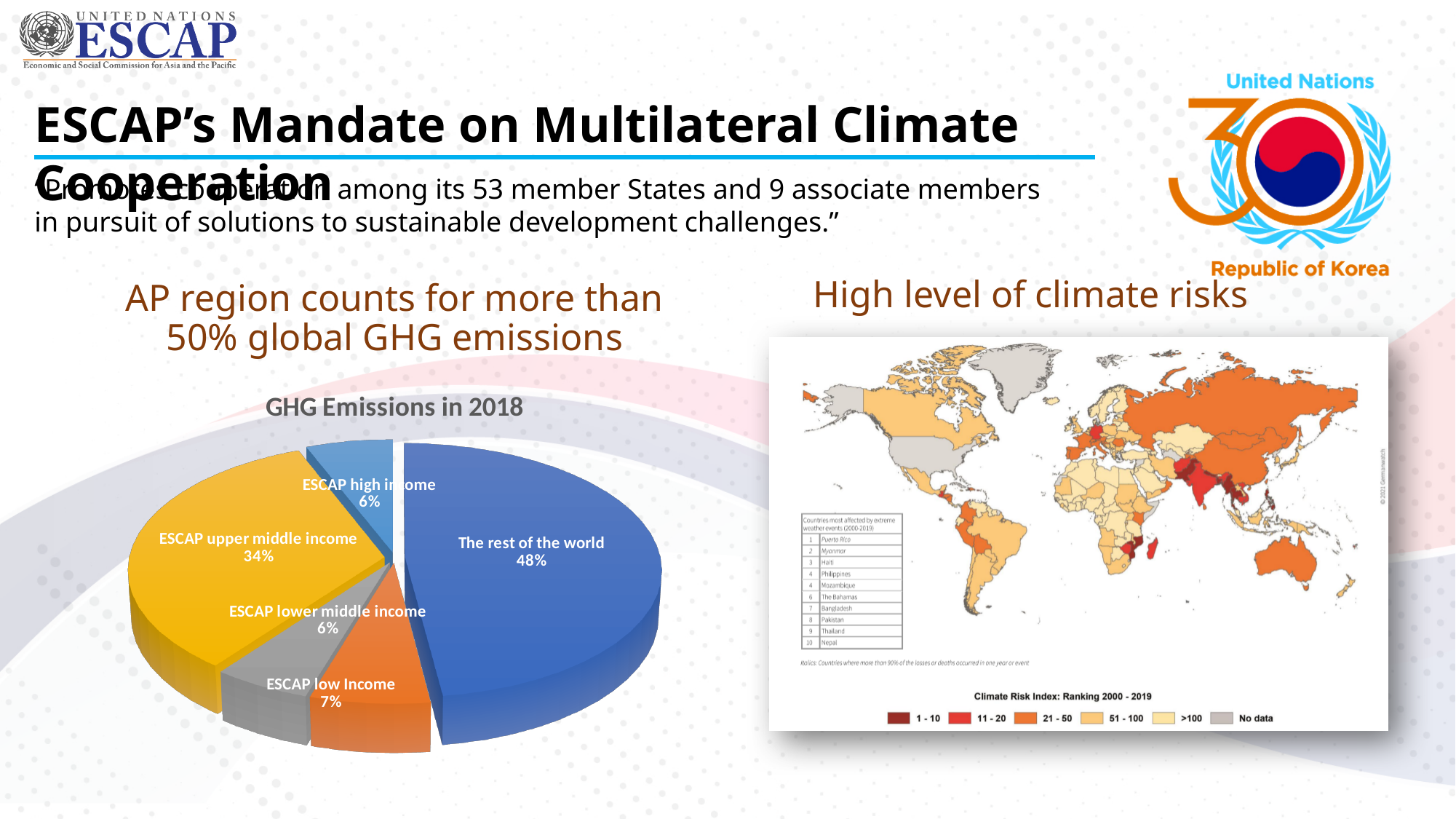
In the GHG Emissions in 2018 chart, what share is attributed to ESCAP lower middle income? 6% What kind of chart is used to show GHG Emissions in 2018? pie chart In the GHG Emissions in 2018 chart, what share is attributed to ESCAP upper middle income? 34% Which slice is the largest in the GHG Emissions in 2018 pie chart? The rest of the world In the GHG Emissions in 2018 chart, what is the difference between The rest of the world and ESCAP upper middle income? 14% How many slices does the GHG Emissions in 2018 pie chart have? 5 In the GHG Emissions in 2018 chart, what share is attributed to ESCAP high income? 6% In the GHG Emissions in 2018 chart, what share is attributed to The rest of the world? 48% What is the title of the pie chart on the slide? GHG Emissions in 2018 In the GHG Emissions in 2018 chart, what share is attributed to ESCAP low Income? 7% In the GHG Emissions in 2018 chart, which is larger: ESCAP low Income or ESCAP lower middle income? ESCAP low Income In the GHG Emissions in 2018 chart, what is the combined share of the four ESCAP income groups? 53%